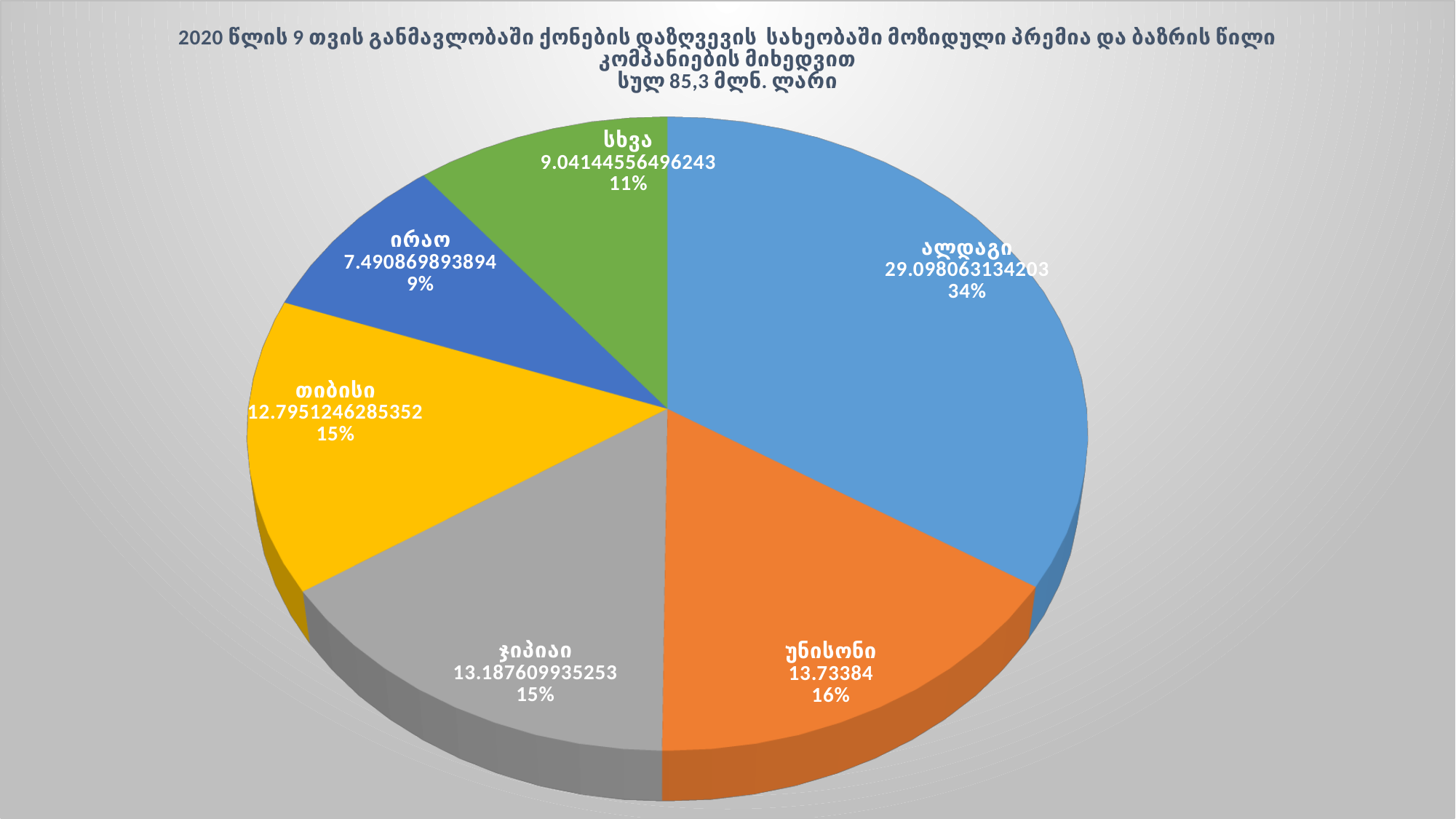
What percentage share does სხვა have in the pie chart? 11% What total amount is stated in the chart title? 85,3 მლნ. ლარი Which is larger, the value for უნისონი or the value for ირაო? უნისონი What is the value shown for ალდაგი? 29.098063134203 What is the value shown for უნისონი? 13.73384 Which category has the smallest slice of the pie? ირაო What is the value shown for ირაო? 7.490869893894 How many slices does the pie chart have? 6 What is the difference in percentage share between ალდაგი (34%) and უნისონი (16%)? 18% What percentage share does ალდაგი have in the pie chart? 34% What kind of chart is shown on the slide? pie chart Which category has the largest slice of the pie? ალდაგი